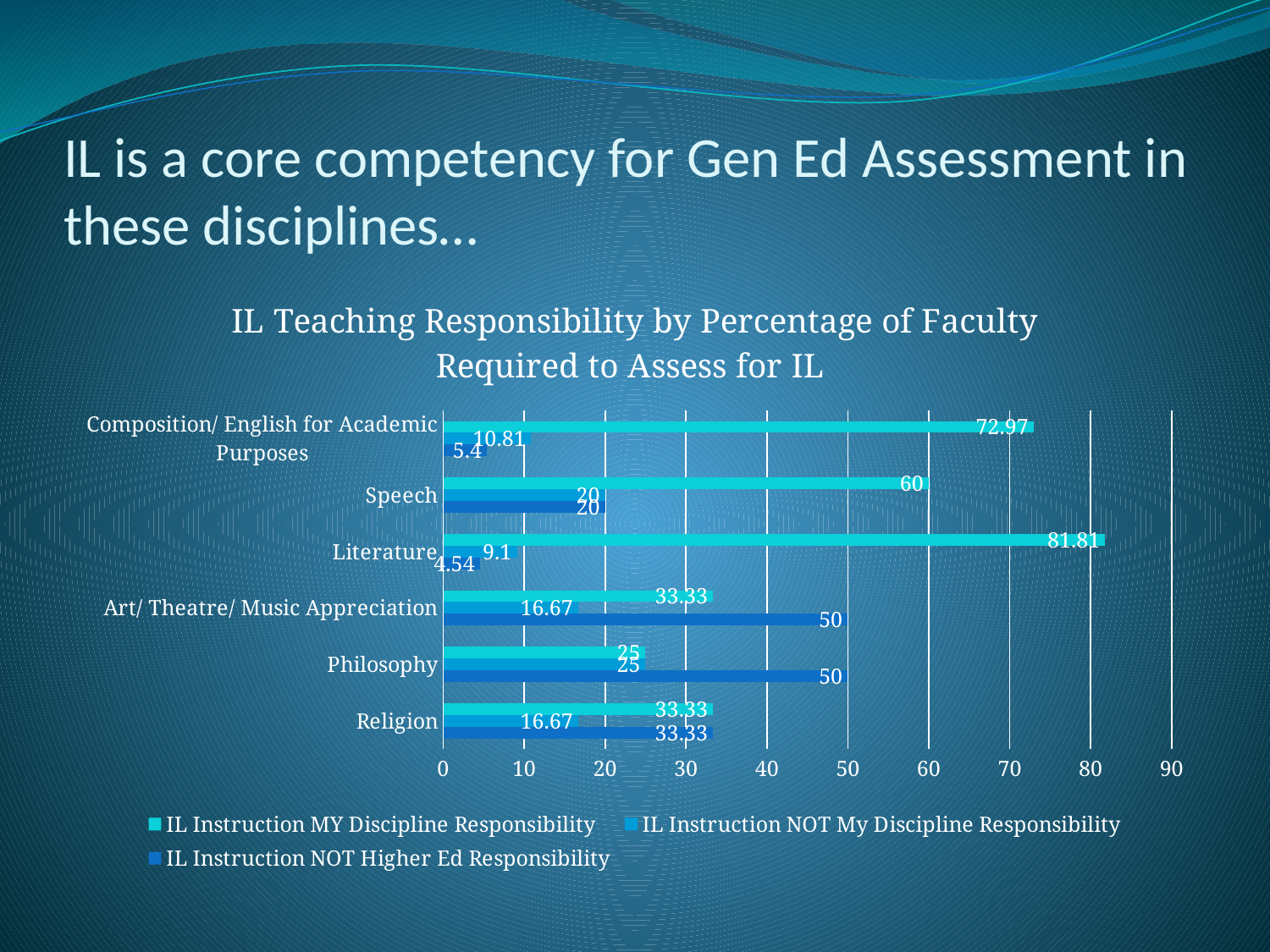
What is the value for Philosophy in the 'IL Instruction NOT Higher Ed Responsibility' series? 50 Which discipline has the highest value in the 'IL Instruction MY Discipline Responsibility' series? Literature What is the value for Speech in the 'IL Instruction NOT My Discipline Responsibility' series? 20 What is the value for Literature in the 'IL Instruction MY Discipline Responsibility' series? 81.81 Which discipline has the lowest value in the 'IL Instruction NOT Higher Ed Responsibility' series? Literature How many series does the legend list? 3 Which has a larger 'IL Instruction MY Discipline Responsibility' value, Speech or Religion? Speech What is the title of the chart? IL Teaching Responsibility by Percentage of Faculty Required to Assess for IL For Composition/ English for Academic Purposes, what is the difference between the 'MY Discipline Responsibility' value and the 'NOT My Discipline Responsibility' value? 62.16 What type of chart is shown on the slide? Bar chart For Art/ Theatre/ Music Appreciation, what is the difference between the 'NOT Higher Ed Responsibility' value and the 'NOT My Discipline Responsibility' value? 33.33 How many disciplines are shown on the chart? 6